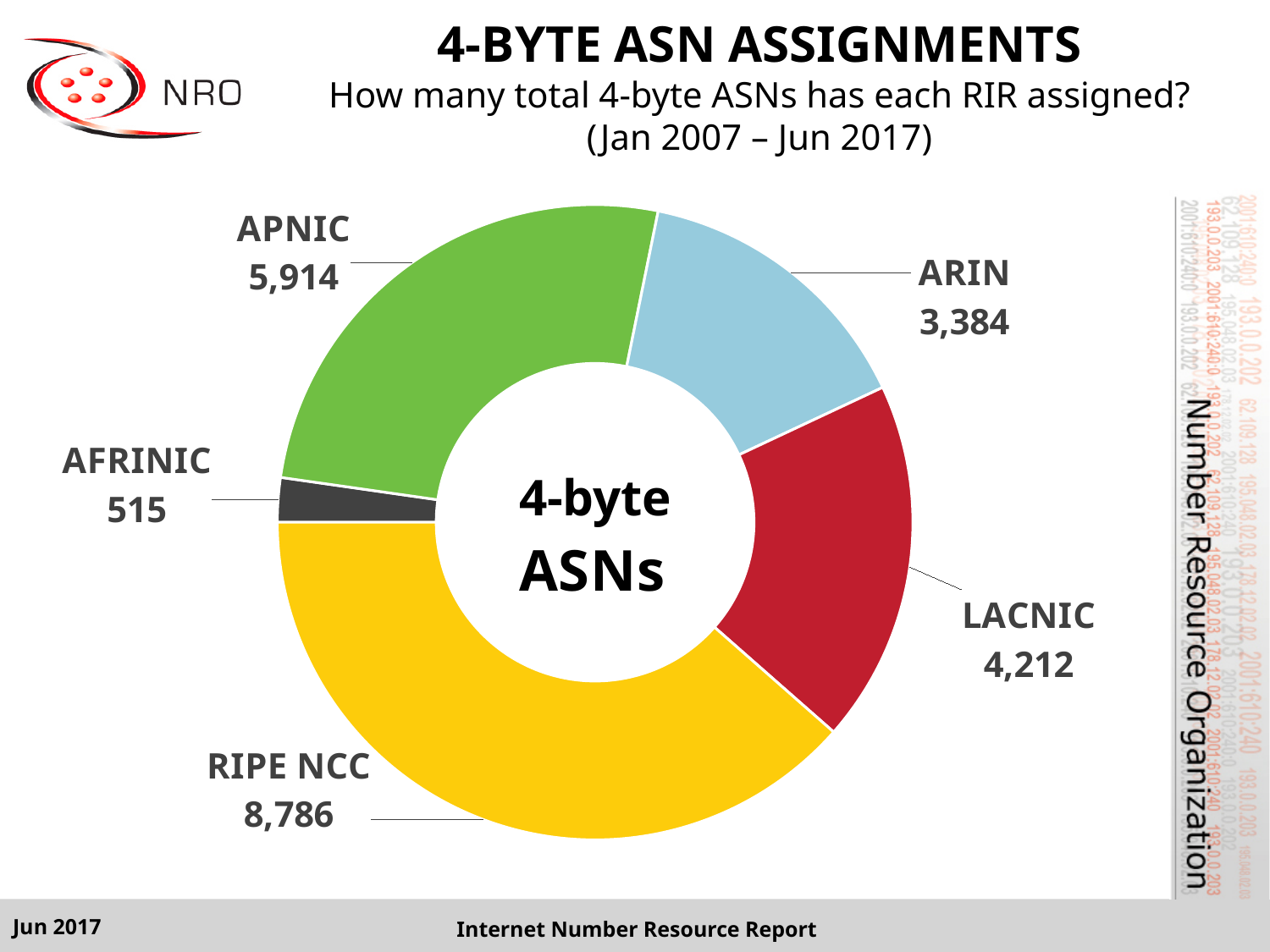
How many 4-byte ASNs has RIPE NCC assigned according to the chart? 8,786 Which RIR has assigned the most 4-byte ASNs? RIPE NCC What is the total number of 4-byte ASNs across all five RIRs shown? 22,811 What is the difference between the LACNIC and ARIN values? 828 What is the value shown for ARIN? 3,384 Which RIR has assigned the fewest 4-byte ASNs? AFRINIC What is the value shown for LACNIC? 4,212 Which has assigned more 4-byte ASNs, APNIC or LACNIC? APNIC What kind of chart is shown on the slide? pie chart (donut) How many RIRs are shown as slices in the chart? 5 What is the difference between the RIPE NCC and APNIC values? 2,872 What text is printed in the centre of the donut chart? 4-byte ASNs